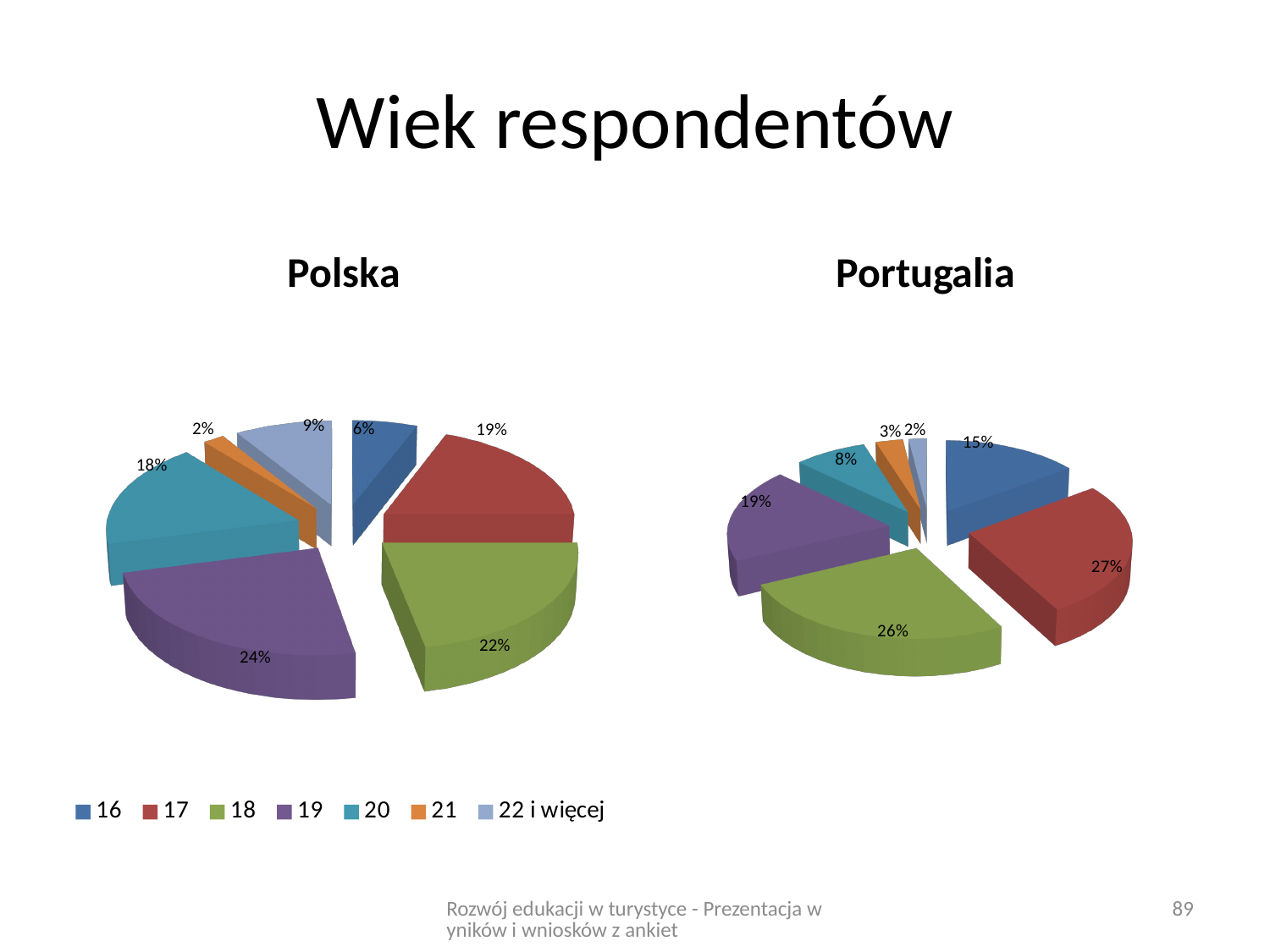
In the Portugalia chart, what share of respondents are aged 20? 8% In the Polska chart, which is larger: the share for age 18 or the share for age 20? 18 In the Polska chart, which age group has the smallest share? 21 What is the title of the slide? Wiek respondentów How many age groups does the legend list? 7 In the Polska chart, what share of respondents are aged 16? 6% In the Polska chart, what share of respondents are aged 19? 24% What kind of chart is used for Polska and Portugalia? Pie chart In the Polska chart, which age group has the largest share? 19 In the Portugalia chart, what share of respondents are aged 17? 27% In the Portugalia chart, which age group has the smallest share? 22 i więcej In the Portugalia chart, what is the difference between the shares for ages 17 and 19? 8%